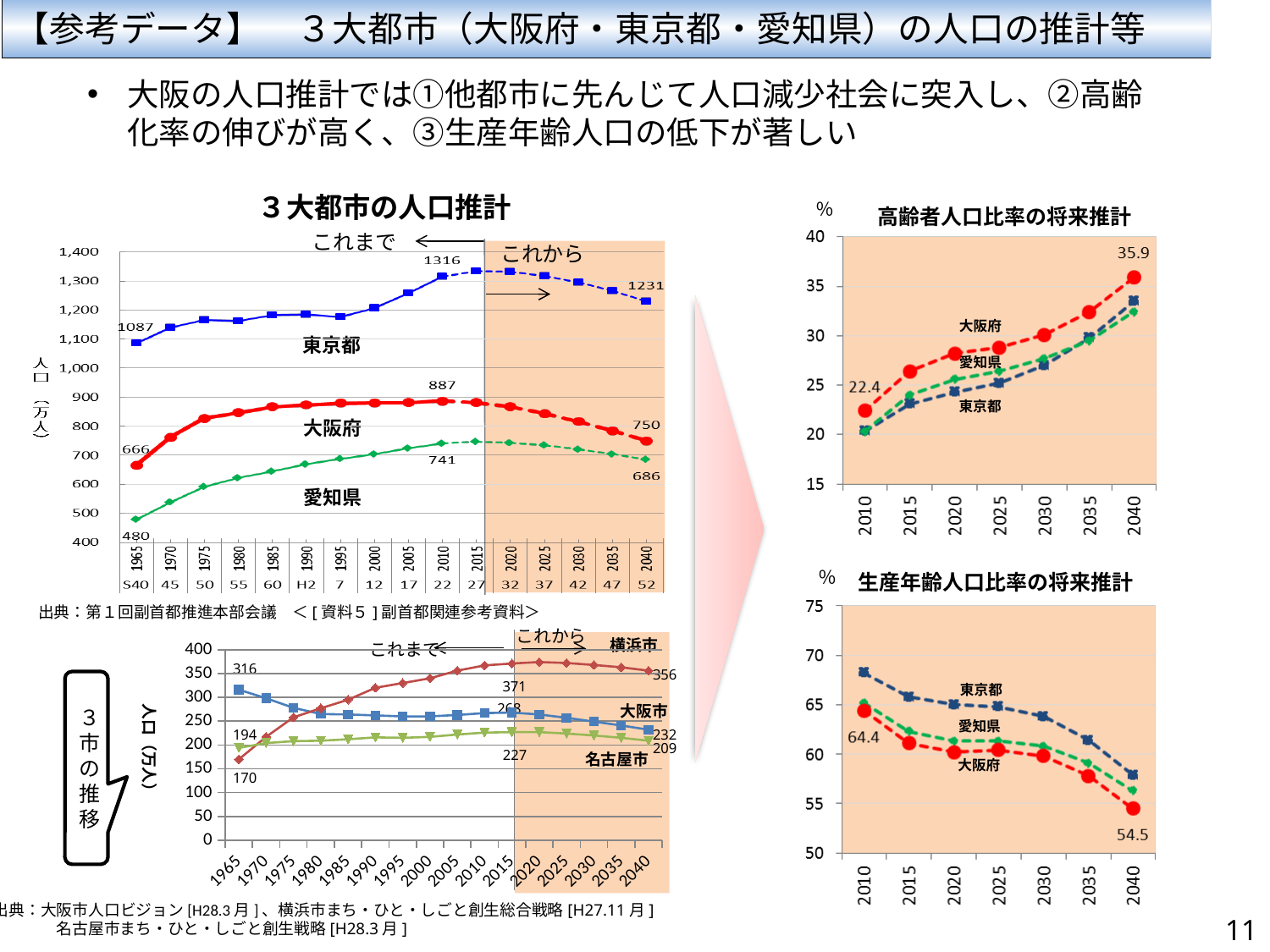
In the chart titled ３大都市の人口推計, which prefecture has the highest population throughout the chart? 東京都 In the chart titled 生産年齢人口比率の将来推計, is the value for 東京都 in 2010 greater or less than 65? greater In the chart titled ３大都市の人口推計, what is the difference between the 大阪府 values in 2010 and 2040? 137 In the bottom-left chart of the three cities (３市の推移), which city has the lowest value in 2040? 名古屋市 In the chart titled 高齢者人口比率の将来推計, what is the value for 大阪府 in 2010? 22.4 In the chart titled 高齢者人口比率の将来推計, do the values rise or fall from 2010 to 2040? rise In the chart titled 生産年齢人口比率の将来推計, what is the value for 大阪府 in 2040? 54.5 In the bottom-left chart of the three cities (３市の推移), what is the value for 横浜市 in 2015? 371 In the chart titled ３大都市の人口推計, what is the value for 大阪府 in 2040? 750 In the chart titled ３大都市の人口推計, what is the value for 愛知県 in 1965? 480 In the chart titled 高齢者人口比率の将来推計, what is the value for 大阪府 in 2040? 35.9 In the chart titled ３大都市の人口推計, what is the value for 東京都 in 2010? 1316